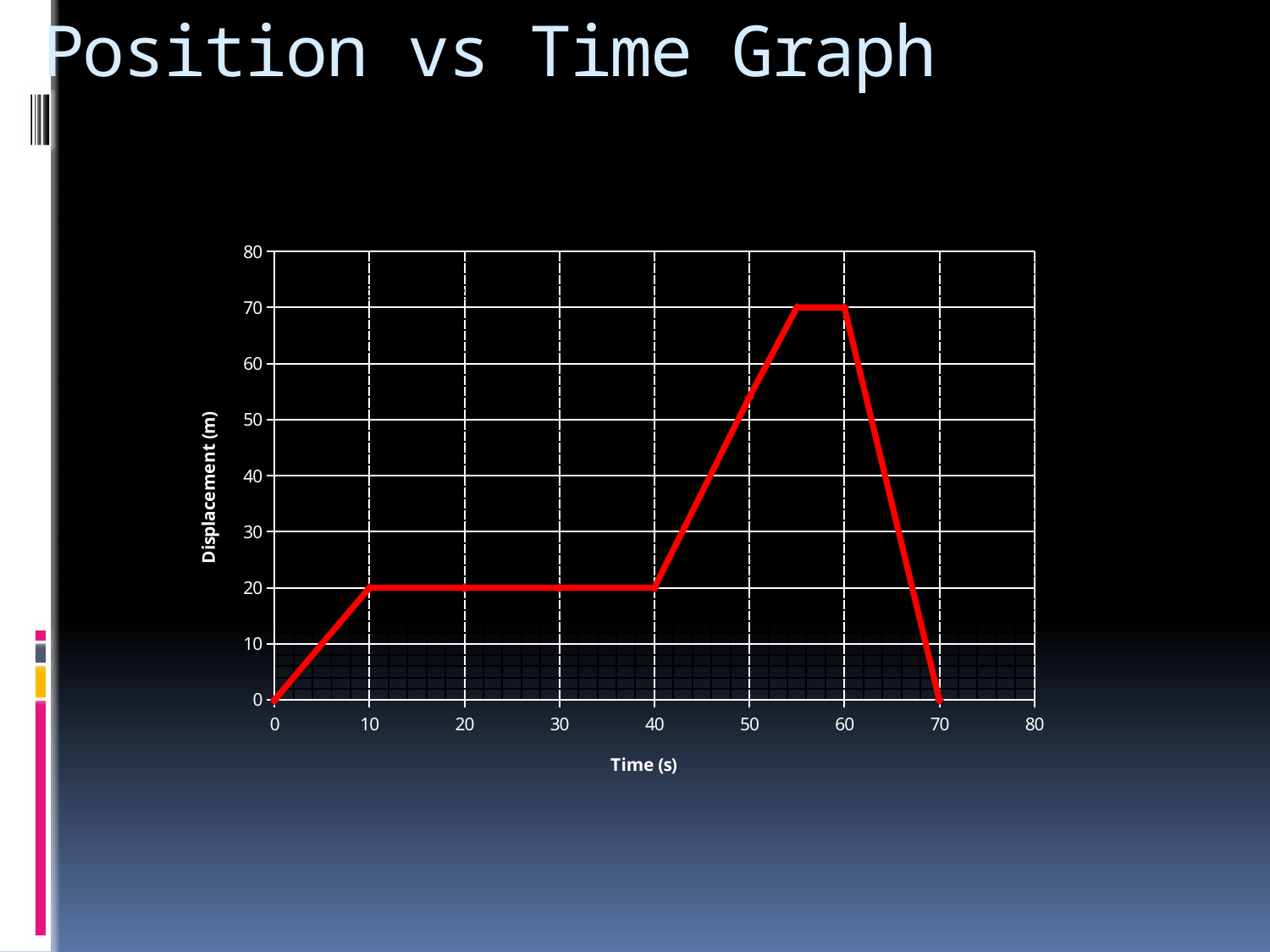
What is the displacement at 60 s? 70 What type of chart is shown on the slide? Line chart What is the label of the vertical axis? Displacement (m) What is the displacement at 70 s? 0 Is the displacement at 50 s greater or less than 40? greater What is the maximum displacement reached on the graph? 70 Is the displacement at 60 s larger or smaller than at 10 s? larger By how much does the displacement change between 40 s and 60 s? 50 What is the title of the slide's chart? Position vs Time Graph Does the displacement rise or fall between 60 s and 70 s? fall What is the displacement at 10 s? 20 What is the displacement at 40 s? 20